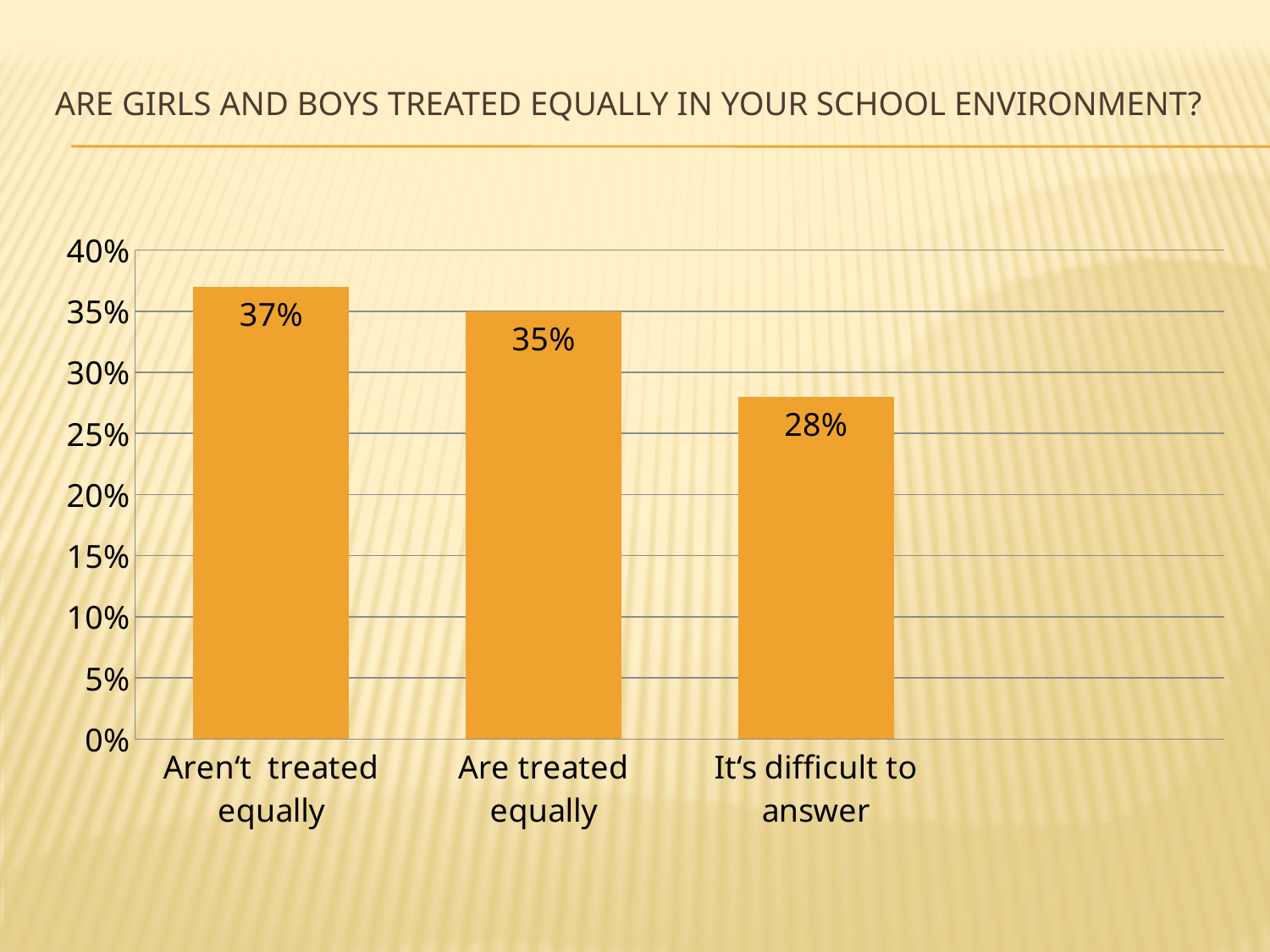
Which response category has the highest value? Aren't treated equally What percentage of respondents said girls and boys aren't treated equally? 37% Which response category has the lowest value? It's difficult to answer What is the value for "Are treated equally"? 35% What is the difference between "Aren't treated equally" and "It's difficult to answer"? 9% How many response categories are shown in the chart? 3 What is the title of the slide? Are girls and boys treated equally in your school environment? What kind of chart is shown on the slide? Bar chart Which is larger: the value for "Are treated equally" or "It's difficult to answer"? Are treated equally What percentage of respondents found it difficult to answer? 28% What is the difference between "Are treated equally" and "It's difficult to answer"? 7% Is the value for "It's difficult to answer" greater or less than 30%? less